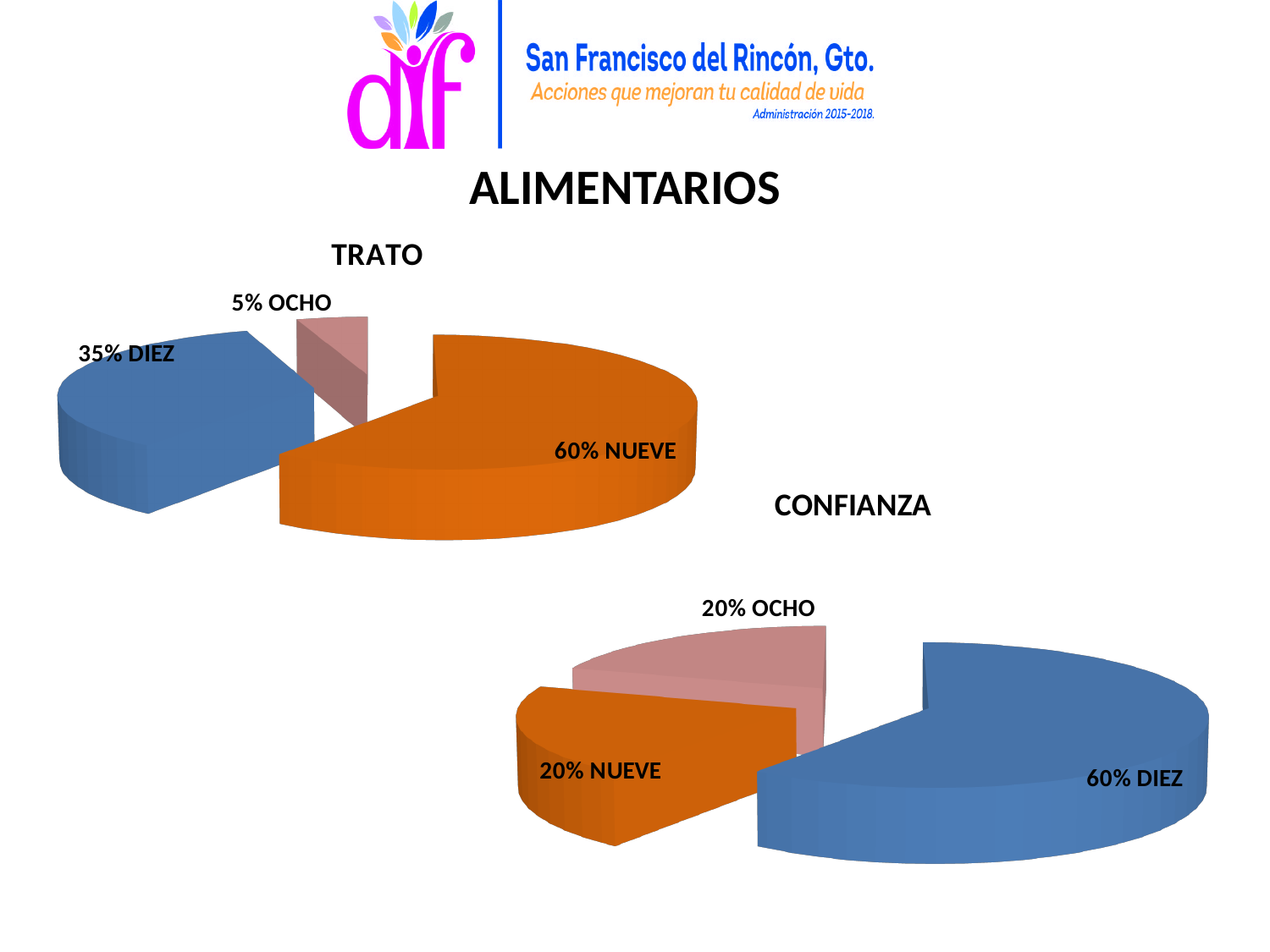
In the TRATO chart, what share does DIEZ have? 35% How many slices does the CONFIANZA chart have? 3 In the TRATO chart, what is the difference between the shares of NUEVE and DIEZ? 25% In the TRATO chart, which category has the largest slice? NUEVE In the TRATO chart, what share does NUEVE have? 60% In the TRATO chart, what share does OCHO have? 5% In the TRATO chart, which category has the smallest slice? OCHO What kind of chart is the TRATO chart? Pie chart In the CONFIANZA chart, what is the difference between the shares of DIEZ and NUEVE? 40% In the CONFIANZA chart, which category has the largest slice? DIEZ